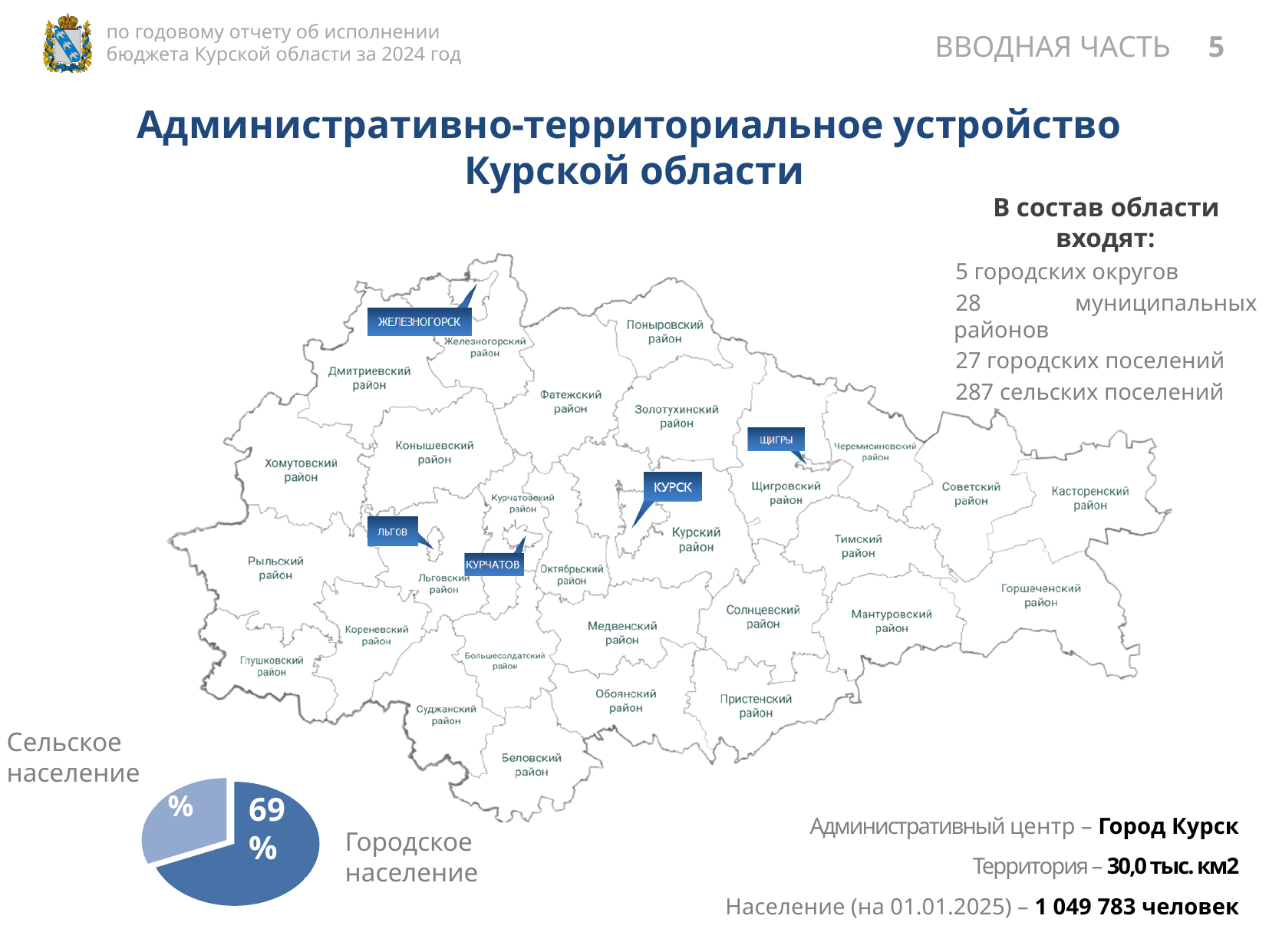
How many slices does the pie chart have? 2 In the pie chart, which slice is drawn in the darker blue colour? Городское население Which category has the smallest slice in the pie chart? Сельское население What kind of chart is shown at the bottom left of the slide? pie chart What are the two categories labelled on the pie chart? Сельское население and Городское население In the pie chart, which slice is larger: Городское население or Сельское население? Городское население Which category has the largest slice in the pie chart? Городское население In the pie chart, what share is shown for Городское население? 69%